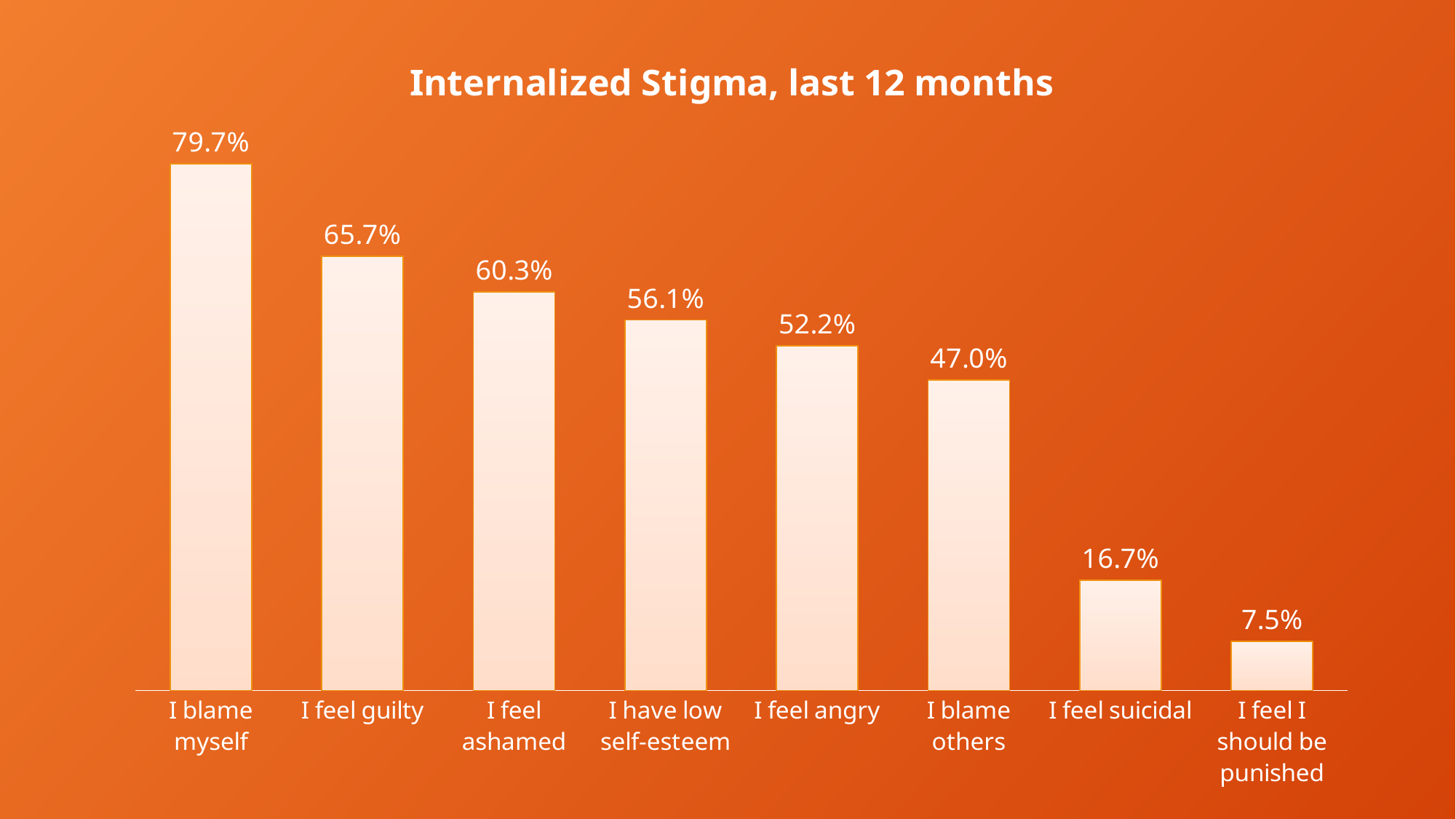
What is the value for "I feel suicidal"? 16.7% Which category has the highest value? I blame myself How many categories are shown in the chart? 8 What is the difference between "I blame myself" and "I feel I should be punished"? 72.2% Which category has the lowest value? I feel I should be punished What kind of chart is this? Bar chart Which is larger, "I feel angry" or "I blame others"? I feel angry What is the value for "I blame myself"? 79.7% What is the value for "I have low self-esteem"? 56.1% Do the values rise or fall from left to right along the x axis? Fall What is the title of the chart? Internalized Stigma, last 12 months What is the difference between "I feel guilty" and "I feel ashamed"? 5.4%